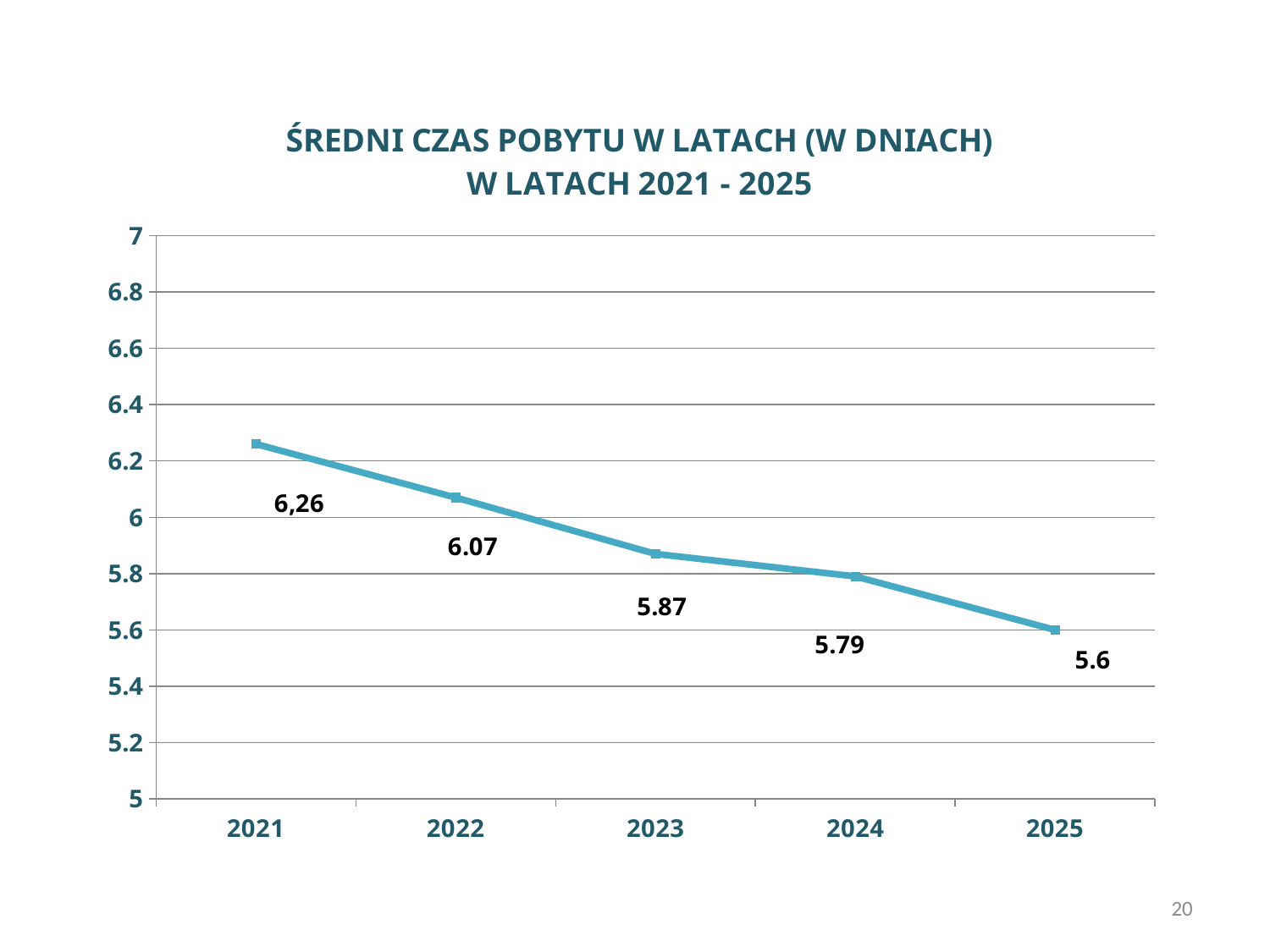
Which year has the lowest value? 2025 What is the value for 2022? 6.07 What is the difference between the values for 2023 and 2024? 0.08 What is the value for 2024? 5.79 What is the value for 2025? 5.6 What is the difference between the values for 2022 and 2023? 0.2 What is the value for 2021? 6,26 Is the value for 2022 greater or less than 6? greater Which is larger, the value for 2023 or the value for 2025? 2023 Which year has the highest value? 2021 How many years are plotted on the chart? 5 What kind of chart is shown on the slide? line chart